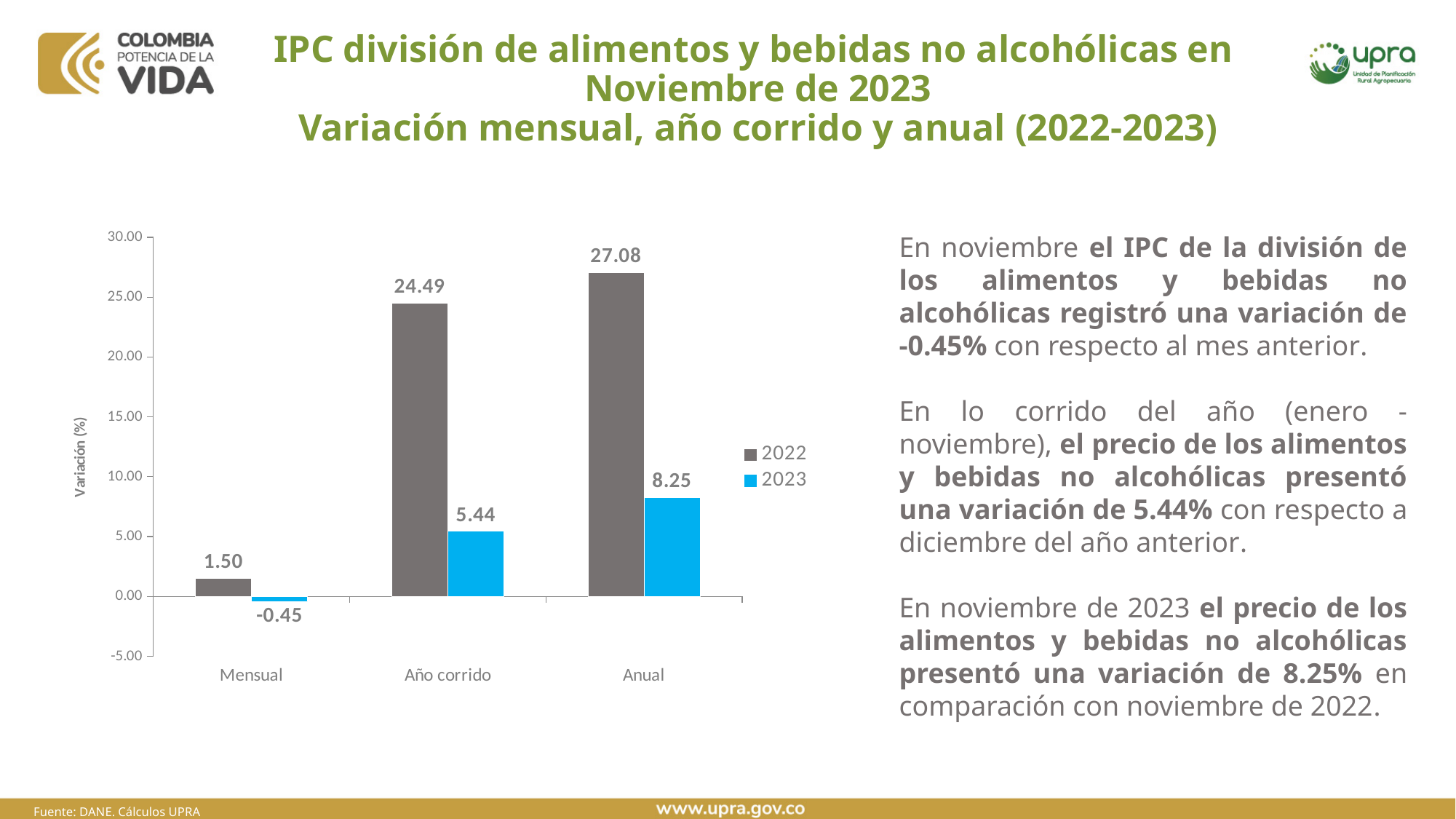
Which category has the highest value for the 2022 series? Anual What is the value for 2023 in the Anual category? 8.25 What is the value for 2022 in the Año corrido category? 24.49 What is the difference between the 2022 values for Año corrido and Anual? 2.59 Which category has the lowest value for the 2023 series? Mensual Which is larger in the Año corrido category, the 2022 value or the 2023 value? 2022 How many categories are shown on the x axis? 3 What is the value for 2023 in the Mensual category? -0.45 What kind of chart is shown on the slide? Bar chart What is the difference between the 2022 and 2023 values in the Anual category? 18.83 How many series does the legend list? 2 Is the 2022 value for Anual greater or less than 25.00? greater